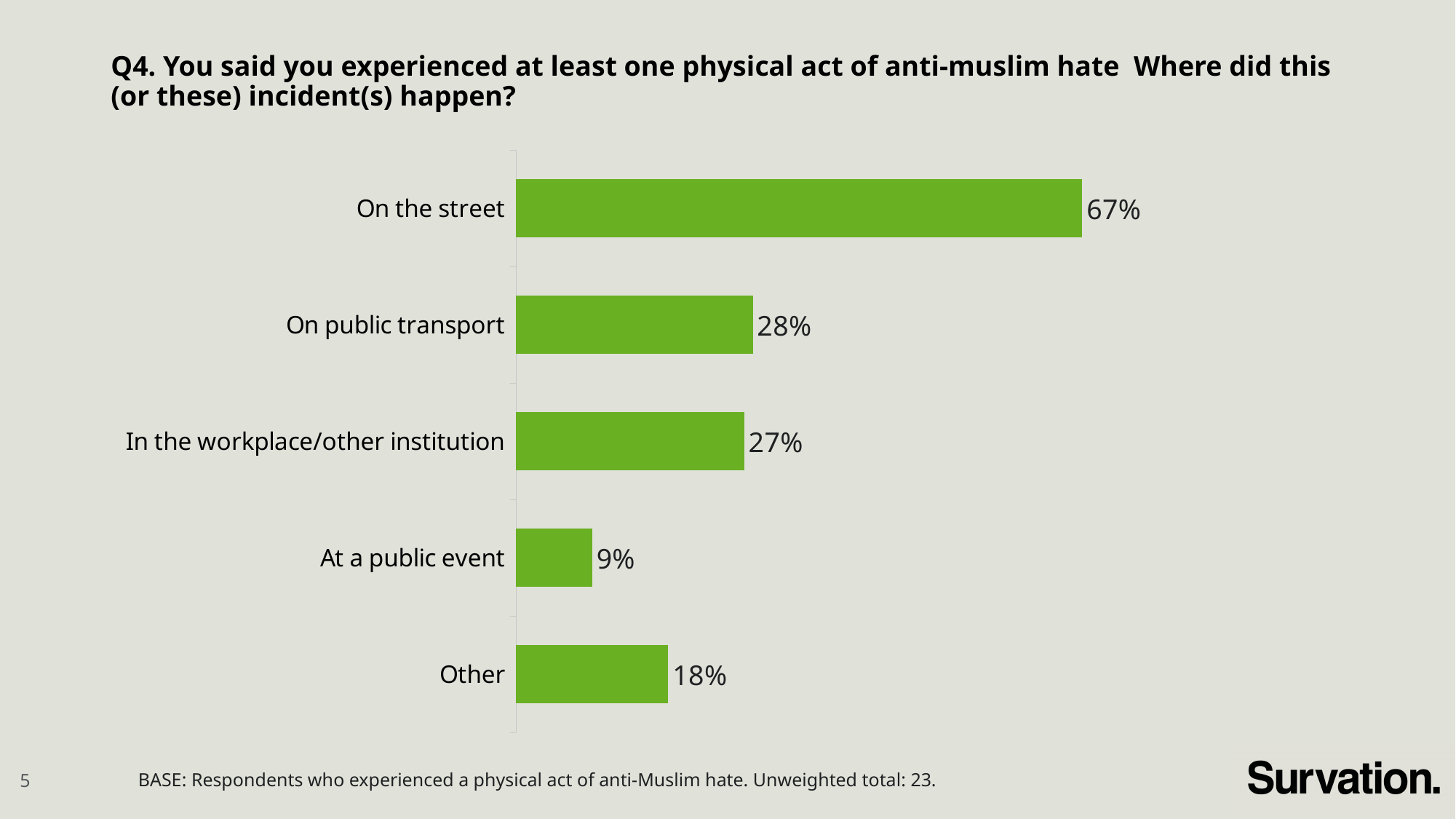
What is the value for 'Other'? 18% How many location categories are shown in the chart? 5 Which location has the lowest percentage? At a public event What is the difference between the values for 'On the street' and 'On public transport'? 39 percentage points What is the unweighted total of respondents stated in the base note? 23 What is the value for 'On public transport'? 28% Which location has the highest percentage? On the street What kind of chart is shown on the slide? Bar chart Which is larger: the value for 'Other' or the value for 'At a public event'? Other What percentage of respondents said the incident(s) happened on the street? 67% What is the value for 'In the workplace/other institution'? 27% What is the value for 'At a public event'? 9%